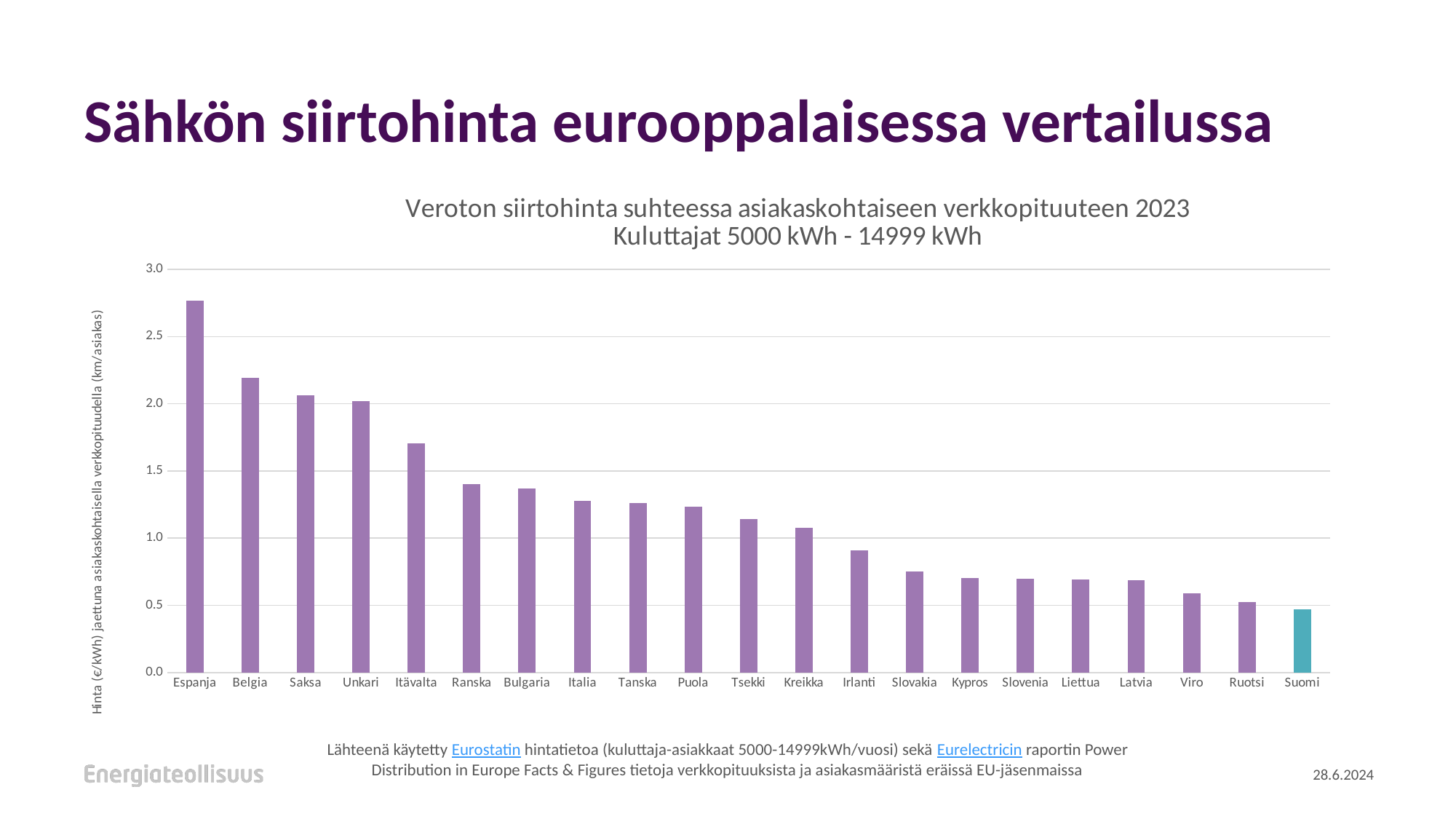
Is the value for Itävalta greater or less than 1.5? greater How many countries are shown on the x axis of the chart? 21 Which country has the highest value in the chart? Espanja Which country has the lowest value in the chart? Suomi What kind of chart is shown on the slide? bar chart Which has a larger value, Belgia or Unkari? Belgia Is the value for Suomi greater or less than 0.5? less Is the value for Ranska greater or less than 1.5? less Do the values rise or fall moving from left to right along the x axis? fall Which country's bar is drawn in a different colour (teal) from the others? Suomi